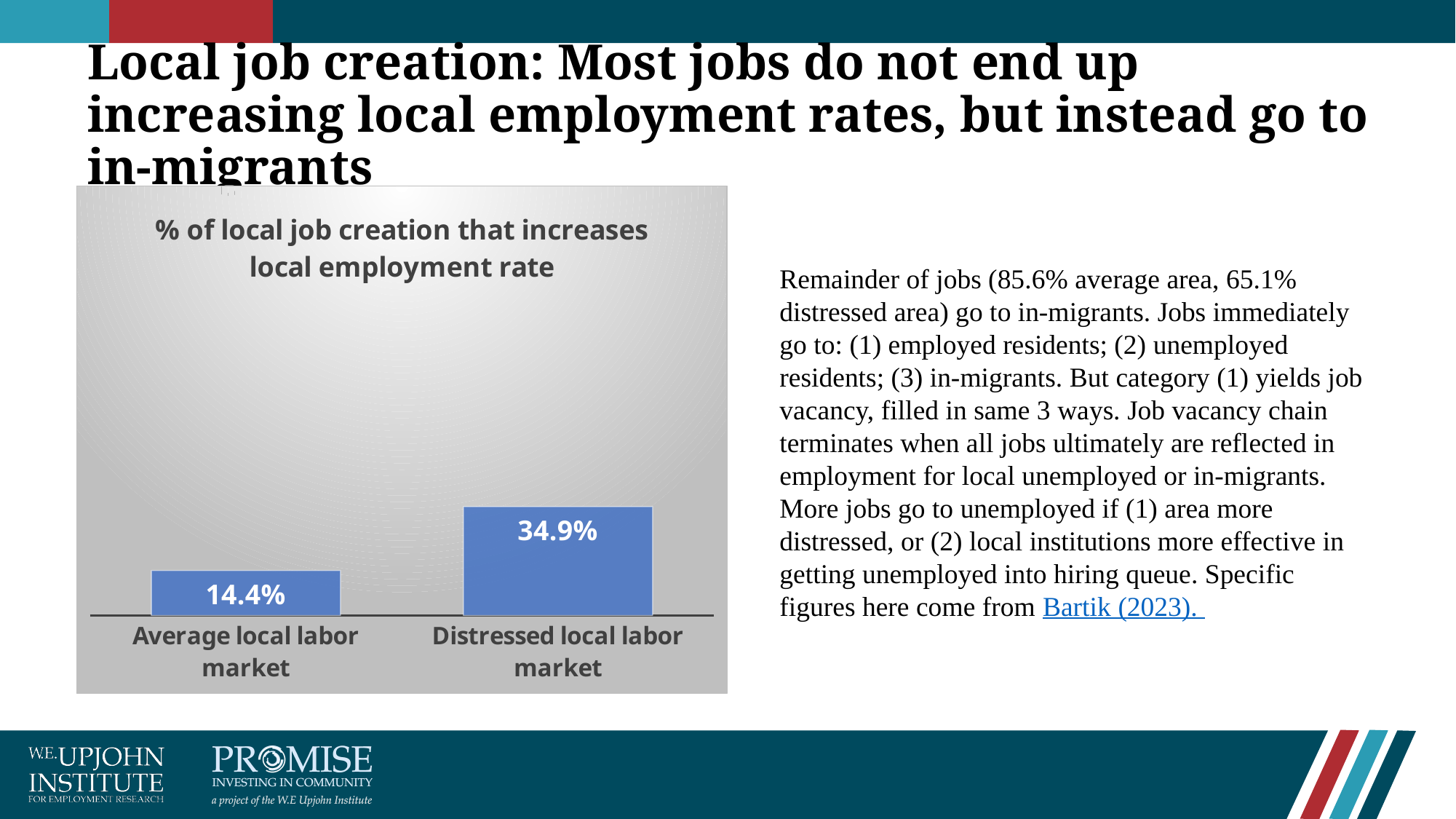
What is the value for Distressed local labor market? 34.9% Which is larger, the value for Average local labor market or Distressed local labor market? Distressed local labor market What kind of chart is shown on the slide? Bar chart What is the title of the chart? % of local job creation that increases local employment rate Which category has the highest value? Distressed local labor market How many categories are shown in the chart? 2 What is the value for Average local labor market? 14.4% What is the difference between the Distressed local labor market and Average local labor market values? 20.5% Which category has the lowest value? Average local labor market What colour are the bars in the chart? Blue